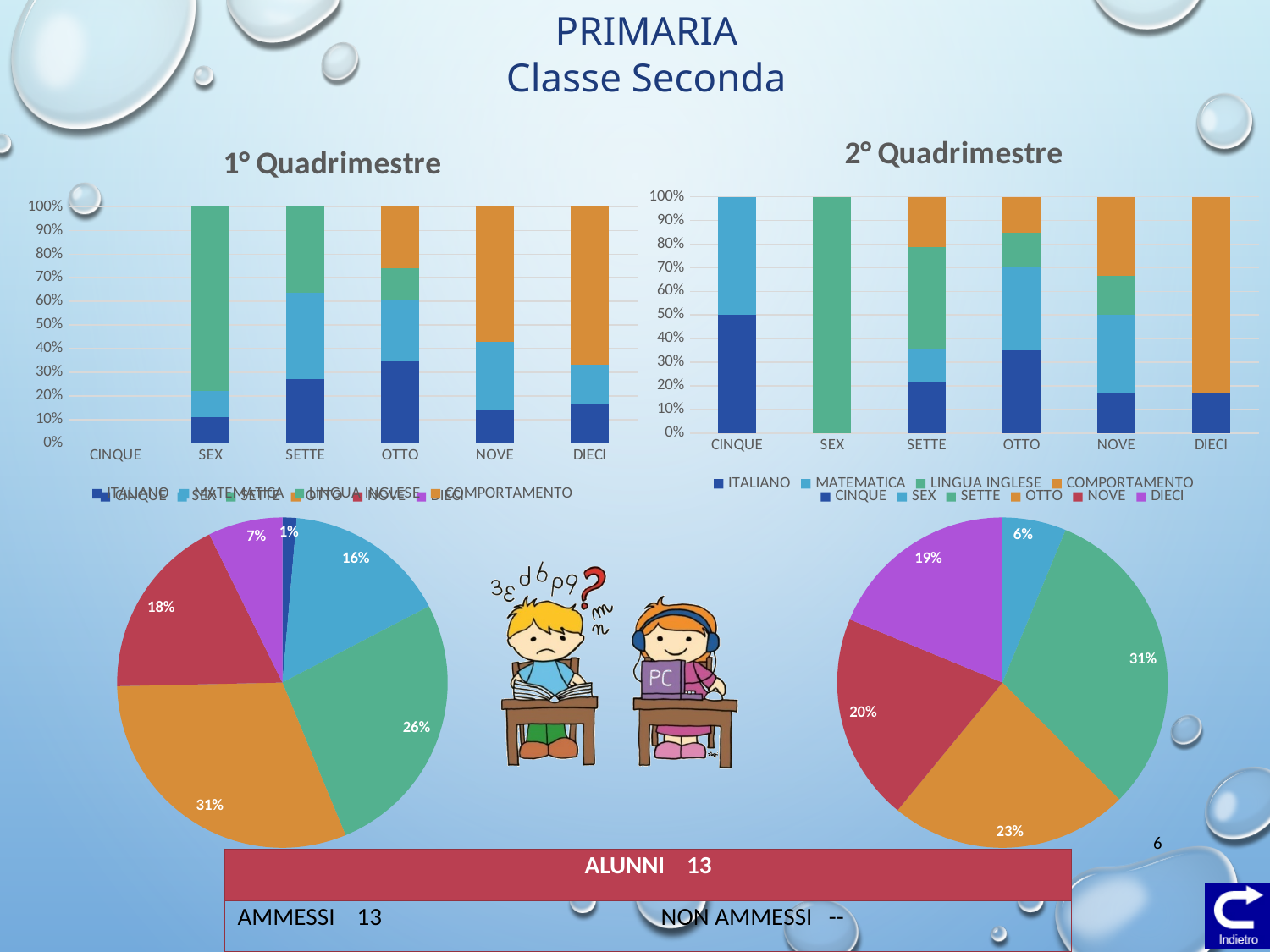
How many series does the legend of the 2° Quadrimestre chart list? 4 In the right pie chart, which category has the largest slice? SETTE In the 2° Quadrimestre chart, is the COMPORTAMENTO segment for DIECI greater or less than 70%? greater What type of chart is the 1° Quadrimestre chart? Stacked bar chart In the left pie chart, what is the difference between the SETTE slice and the SEX slice? 10% In the left pie chart, what percentage is shown for the CINQUE slice? 1% In the 1° Quadrimestre chart, is the ITALIANO segment for SEX greater or less than 20%? less How many categories are shown on the x axis of the 2° Quadrimestre chart? 6 In the left pie chart, what percentage is shown for the OTTO slice? 31% In the right pie chart, which is larger, the OTTO slice or the DIECI slice? OTTO In the right pie chart, what percentage is shown for the NOVE slice? 20% In the left pie chart, which category has the smallest slice? CINQUE